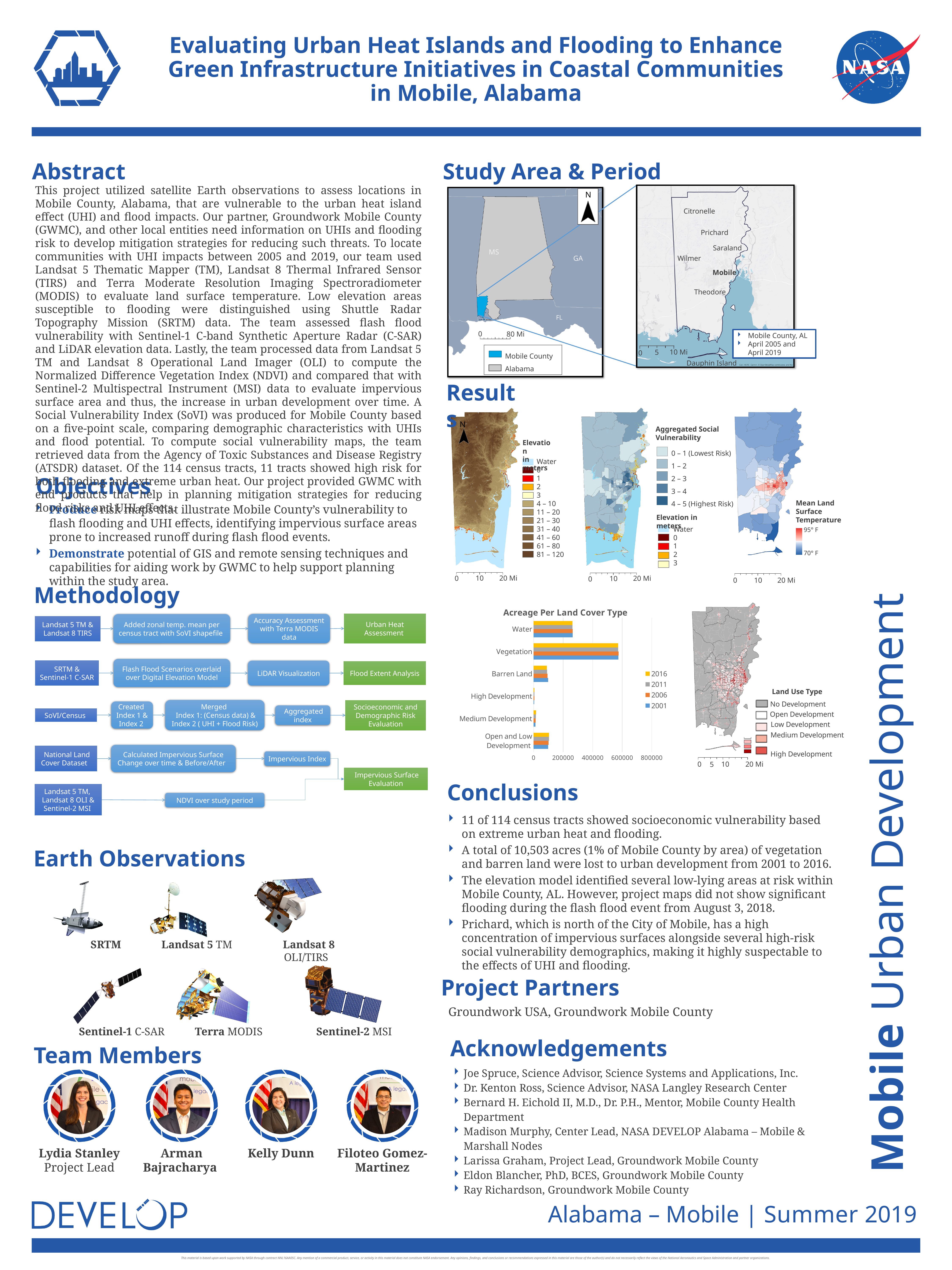
In the "Acreage Per Land Cover Type" chart, is the 2016 value for Water greater or less than 200000? greater In the "Acreage Per Land Cover Type" chart, which has more acreage in 2001: Vegetation or Water? Vegetation What kind of chart is "Acreage Per Land Cover Type"? bar chart In the "Acreage Per Land Cover Type" chart, which has more acreage in 2016: Water or Barren Land? Water Which years are listed in the legend of the "Acreage Per Land Cover Type" chart? 2016, 2011, 2006, 2001 How many series does the legend of the "Acreage Per Land Cover Type" chart list? 4 In the "Acreage Per Land Cover Type" chart, which has more acreage in 2016: Open and Low Development or High Development? Open and Low Development Which land cover type has the highest acreage in the "Acreage Per Land Cover Type" chart? Vegetation In the "Acreage Per Land Cover Type" chart, is the 2016 value for Barren Land greater or less than 200000? less How many land cover categories are shown in the "Acreage Per Land Cover Type" chart? 6 What is the title of the bar chart on the slide? Acreage Per Land Cover Type In the "Acreage Per Land Cover Type" chart, is the 2016 value for Vegetation greater or less than 400000? greater